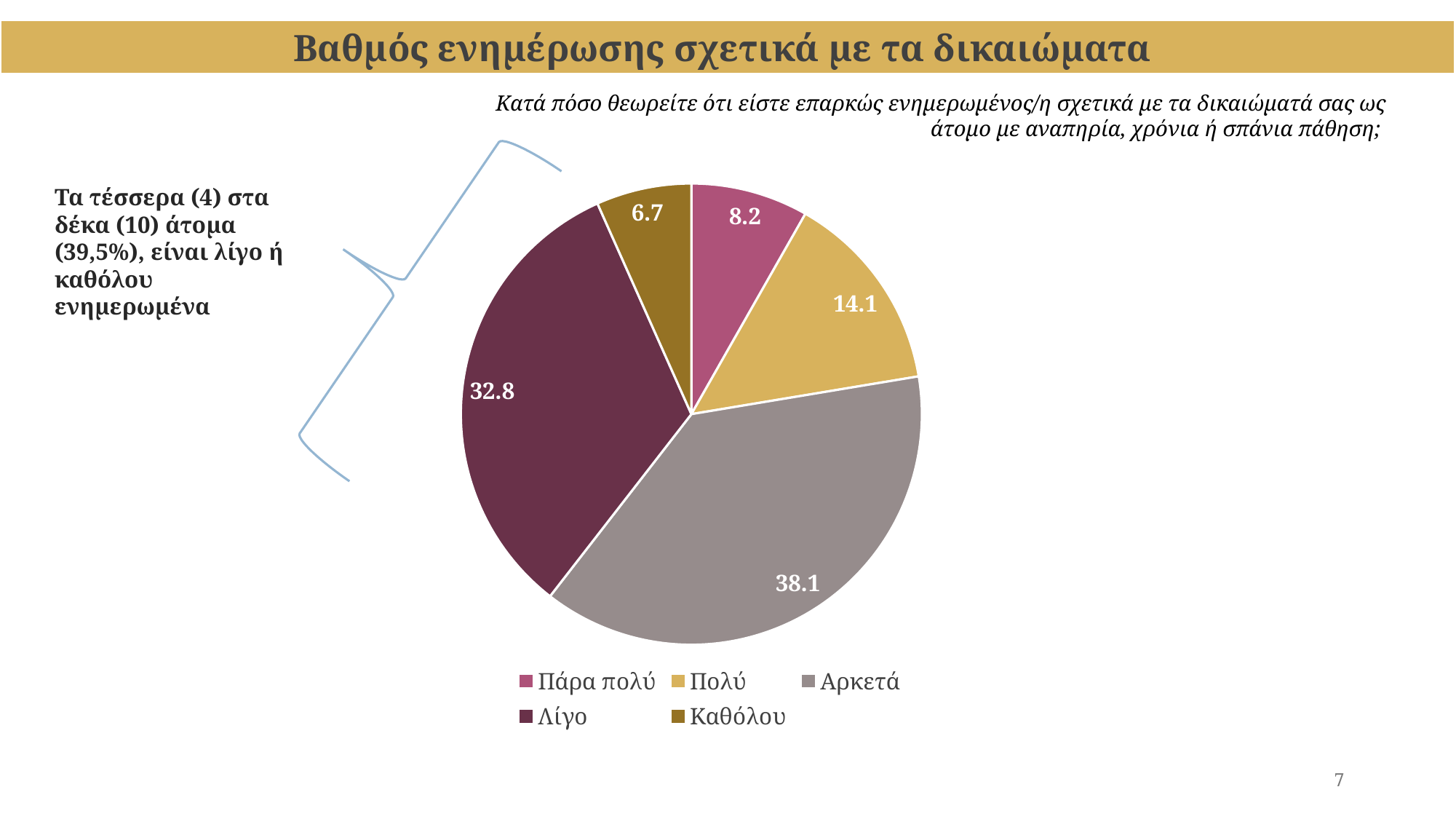
What is the value for Καθόλου? 6.7 Which is larger, the value for Πολύ or the value for Πάρα πολύ? Πολύ Which legend entry is shown in grey? Αρκετά What is the difference between the values for Αρκετά and Λίγο? 5.3 Which category has the largest slice? Αρκετά Which category has the smallest slice? Καθόλου What kind of chart is shown on the slide? pie chart How many slices does the pie chart have? 5 What is the value for Αρκετά? 38.1 What is the combined value of Λίγο and Καθόλου? 39.5 What is the value for Λίγο? 32.8 What is the value for Πάρα πολύ? 8.2